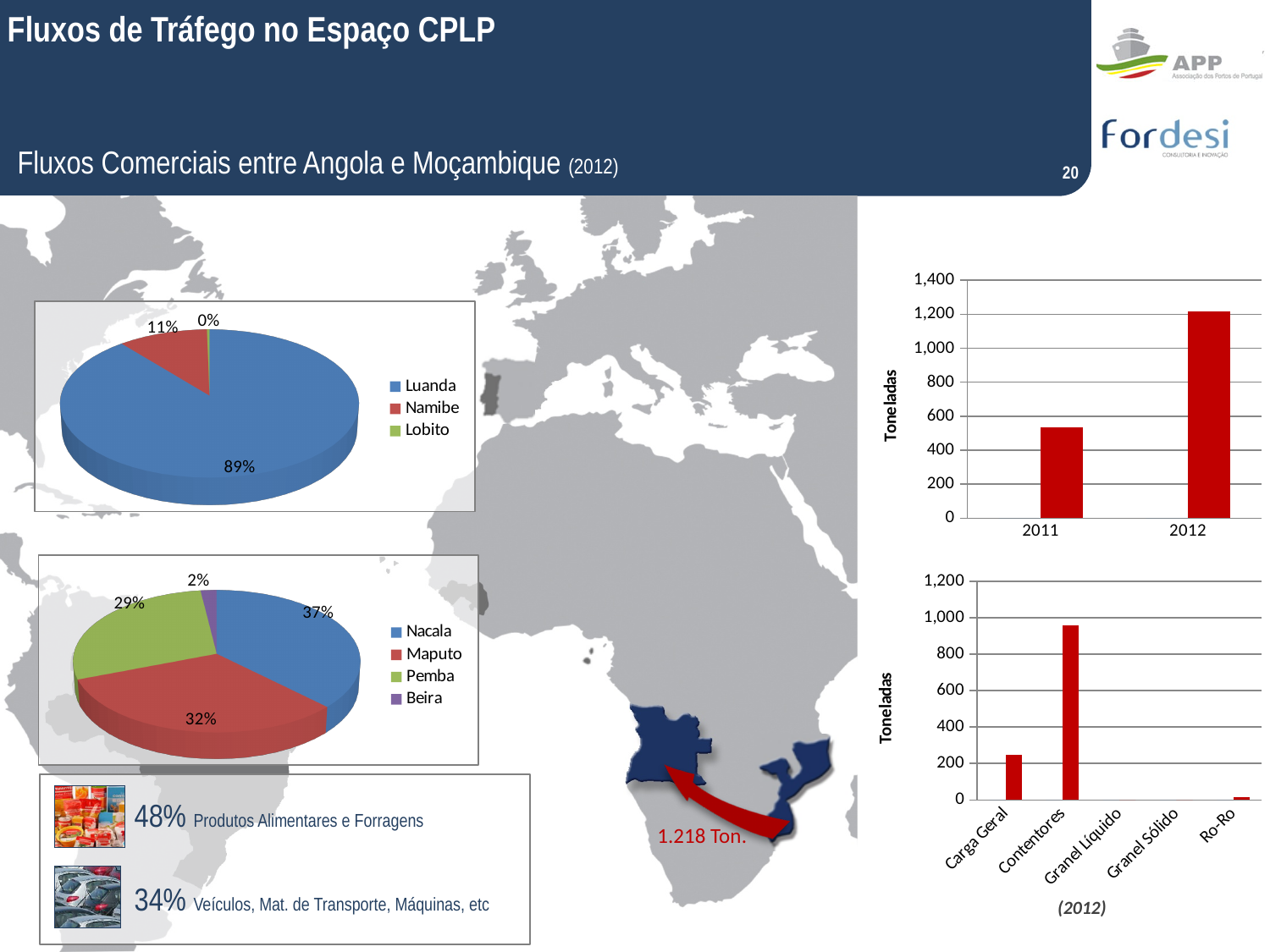
In the top-right bar chart, do the values rise or fall from 2011 to 2012? rise In the bottom-right bar chart, which category has the highest value? Contentores In the top-right bar chart, is the value for 2011 greater or less than 600? less In the top-left pie chart, what share does Luanda have? 89% In the top-left pie chart, which port has the smallest share? Lobito How many entries does the legend of the bottom-left pie chart list? 4 In the bottom-left pie chart, what is the difference between the shares of Nacala and Pemba? 8% In the bottom-left pie chart, which port has the largest share? Nacala In the bottom-left pie chart, what share does Maputo have? 32% How many categories are shown on the x axis of the bottom-right bar chart? 5 In the top-right bar chart, is the value for 2012 greater or less than 1,000? greater In the top-left pie chart, what share does Namibe have? 11%